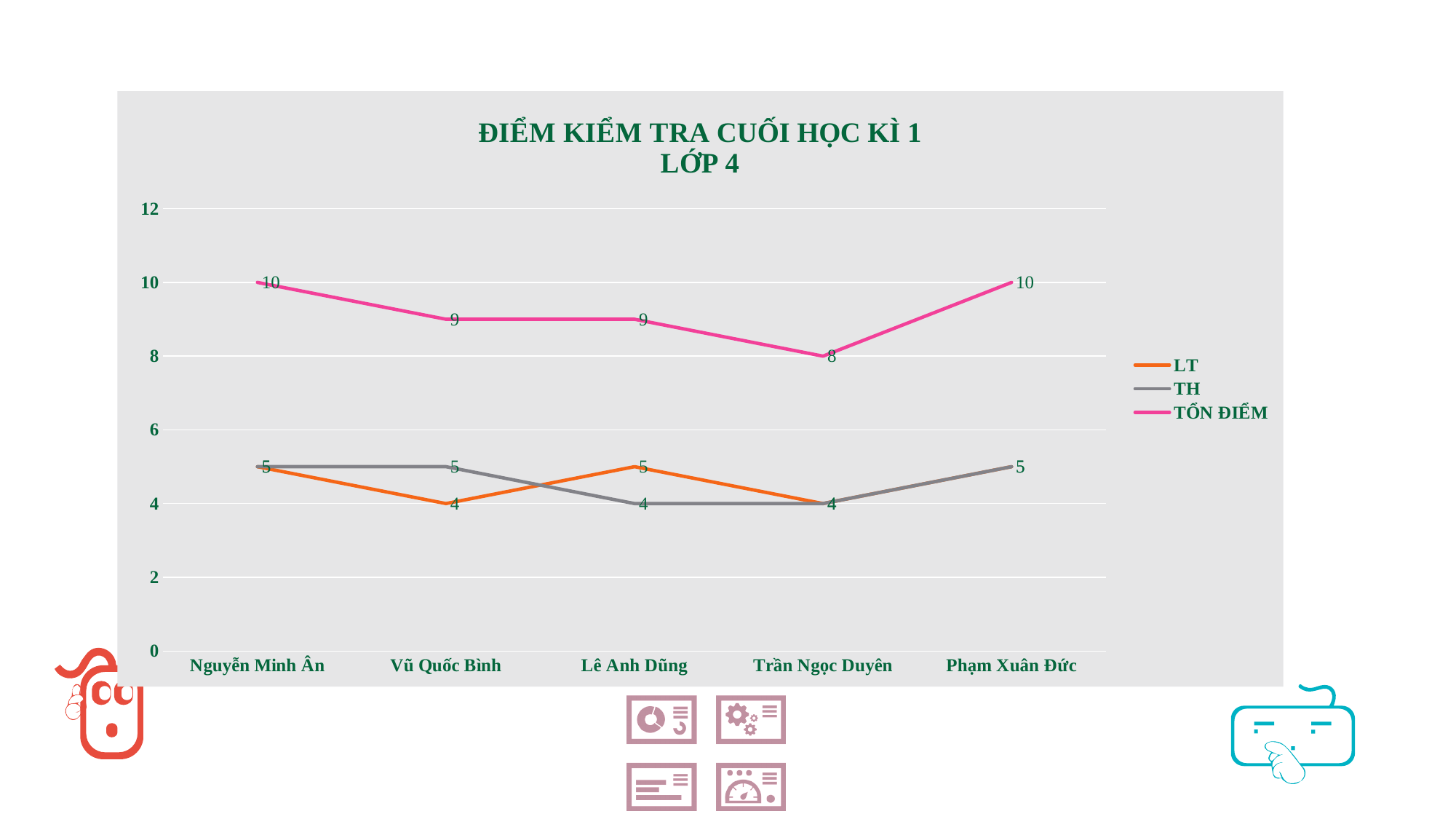
Which students have the highest TỔN ĐIỂM value? Nguyễn Minh Ân and Phạm Xuân Đức What is the TỔN ĐIỂM value for Trần Ngọc Duyên? 8 Does the TỔN ĐIỂM line rise or fall from Nguyễn Minh Ân to Trần Ngọc Duyên? Fall What is the title of the chart? ĐIỂM KIỂM TRA CUỐI HỌC KÌ 1 LỚP 4 How many students are shown on the x axis? 5 What kind of chart is shown on the slide? Line chart Which student has the lowest TỔN ĐIỂM value? Trần Ngọc Duyên What is the TH value for Lê Anh Dũng? 4 What is the LT value for Vũ Quốc Bình? 4 How many series does the legend list? 3 For Vũ Quốc Bình, which is larger, the LT value or the TH value? TH What is the difference between the TỔN ĐIỂM values for Nguyễn Minh Ân and Trần Ngọc Duyên? 2